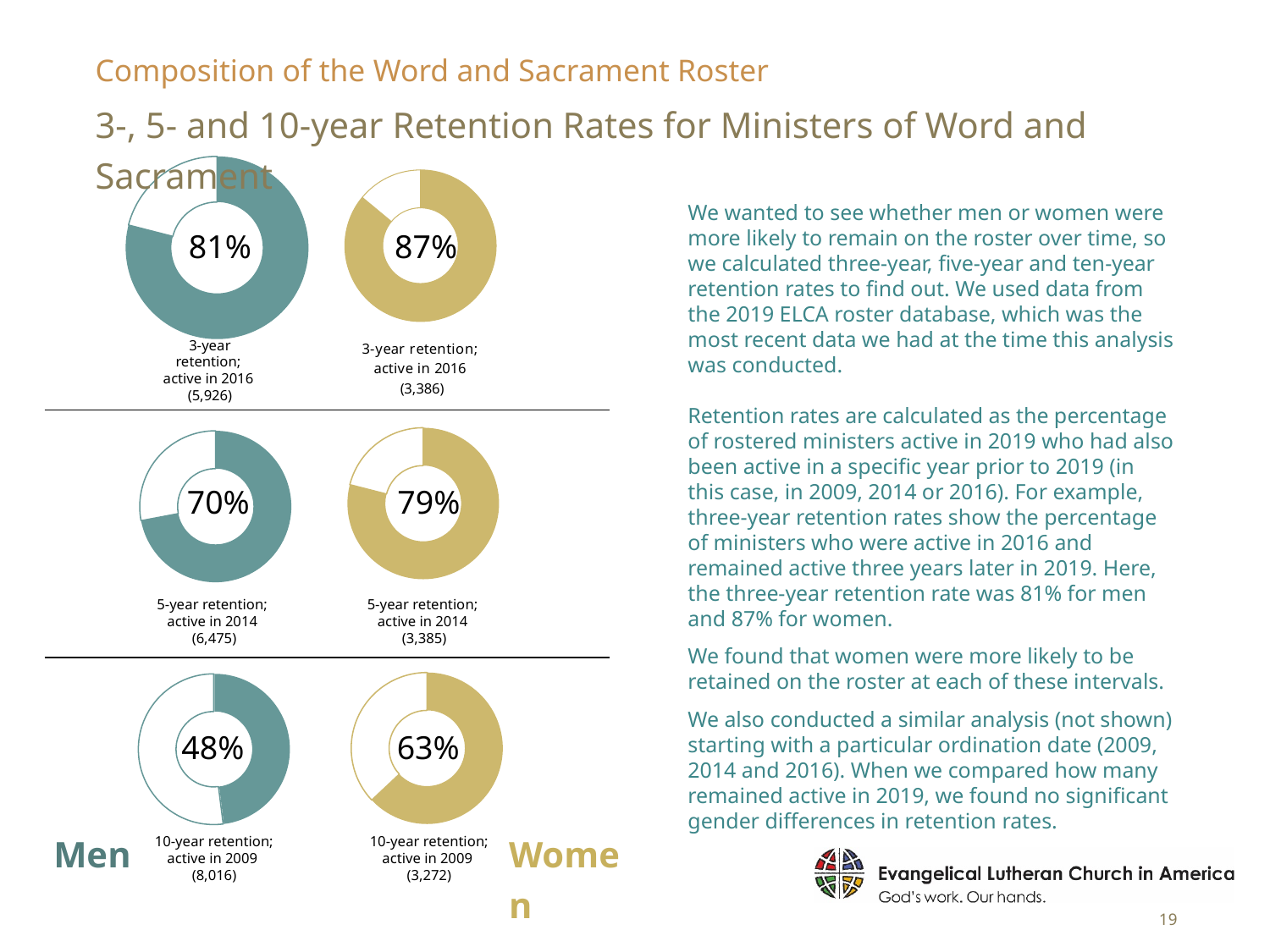
What is the 5-year retention rate shown in the donut chart for men (middle left)? 70% What is the 3-year retention rate shown in the donut chart for women (top right)? 87% Is the 10-year retention rate higher for men or for women? Women Which of the six donut charts shows the lowest retention rate? 10-year retention for men (48%) What is the 10-year retention rate shown in the donut chart for men (bottom left)? 48% What is the difference between the 5-year retention rates for women and men? 9 percentage points How many donut charts are shown on the slide? 6 What is the 10-year retention rate shown in the donut chart for women (bottom right)? 63% What is the 3-year retention rate shown in the donut chart for men (top left)? 81% Which of the six donut charts shows the highest retention rate? 3-year retention for women (87%) What kind of chart is used to show the retention rates on this slide? Donut (pie) chart How many men were active in 2009, according to the label under the men's 10-year retention chart? 8,016